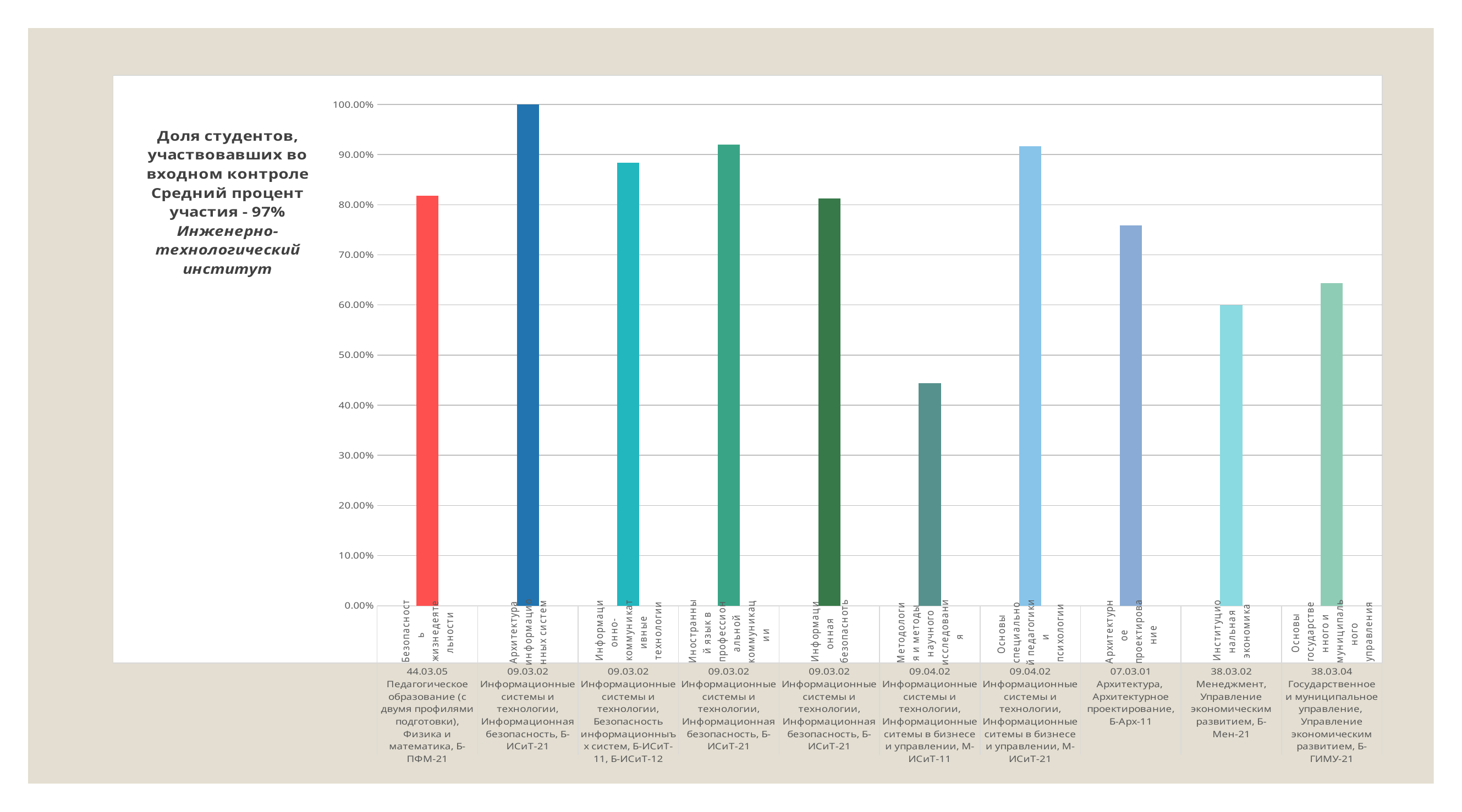
What is the value of the bar for Архитектура информационных систем (09.03.02, Б-ИСиТ-21)? 100.00% What kind of chart is shown on the slide? bar chart Which discipline has the highest share of students who took part in the entrance control? Архитектура информационных систем Which is larger: the value for Иностранный язык в профессиональной коммуникации or the value for Информационная безопасность? Иностранный язык в профессиональной коммуникации Is the value for Основы государственного и муниципального управления greater or less than 70.00%? less According to the chart title, what is the average participation percentage (Средний процент участия) for the institute? 97% Which is larger: the value for Институциональная экономика or the value for Основы государственного и муниципального управления? Основы государственного и муниципального управления Is the value for Архитектурное проектирование (07.03.01, Б-Арх-11) greater or less than 80.00%? less Is the value for Методология и методы научного исследования greater or less than 50.00%? less How many bars (disciplines) are plotted in the chart? 10 Which discipline has the lowest share of participating students? Методология и методы научного исследования